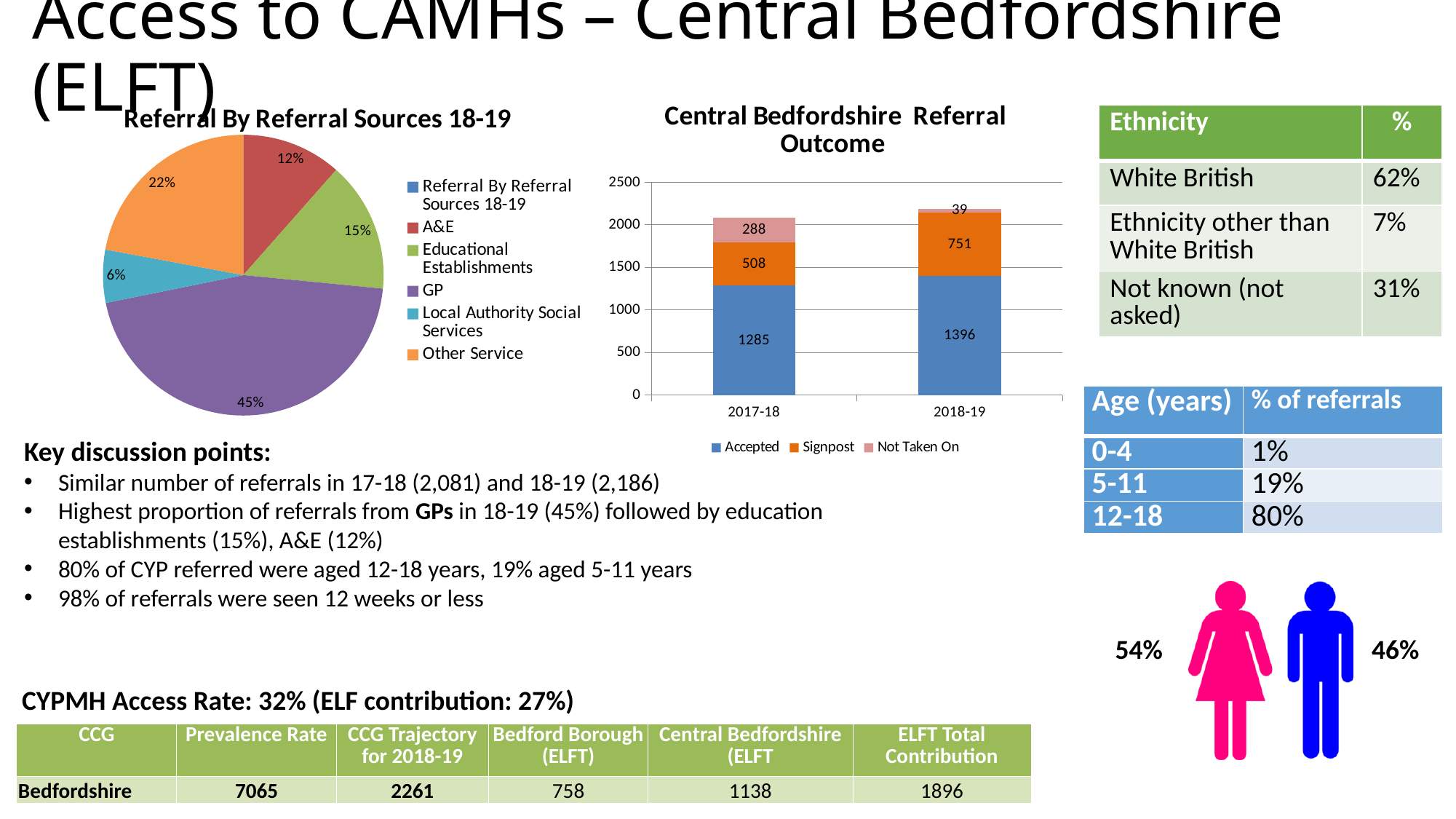
In the pie chart 'Referral By Referral Sources 18-19', which referral source has the smallest share? Local Authority Social Services In the pie chart 'Referral By Referral Sources 18-19', what share of referrals came from GP? 45% How many series does the legend of the 'Central Bedfordshire Referral Outcome' chart list? 3 In the 'Central Bedfordshire Referral Outcome' chart, how much higher is the Signpost value in 2018-19 than in 2017-18? 243 In the 'Central Bedfordshire Referral Outcome' chart, what is the Not Taken On value for 2017-18? 288 In the pie chart 'Referral By Referral Sources 18-19', what share of referrals came from Local Authority Social Services? 6% In the pie chart 'Referral By Referral Sources 18-19', which is larger: the share for Other Service or the share for Educational Establishments? Other Service What kind of chart is 'Central Bedfordshire Referral Outcome'? Stacked bar chart In the 'Central Bedfordshire Referral Outcome' chart, what is the Accepted value for 2018-19? 1396 In the 'Central Bedfordshire Referral Outcome' chart, what is the total of the 2018-19 bar? 2186 In the pie chart 'Referral By Referral Sources 18-19', what is the difference in percentage points between the A&E share and the Educational Establishments share? 3 percentage points In the pie chart 'Referral By Referral Sources 18-19', which referral source has the largest share? GP